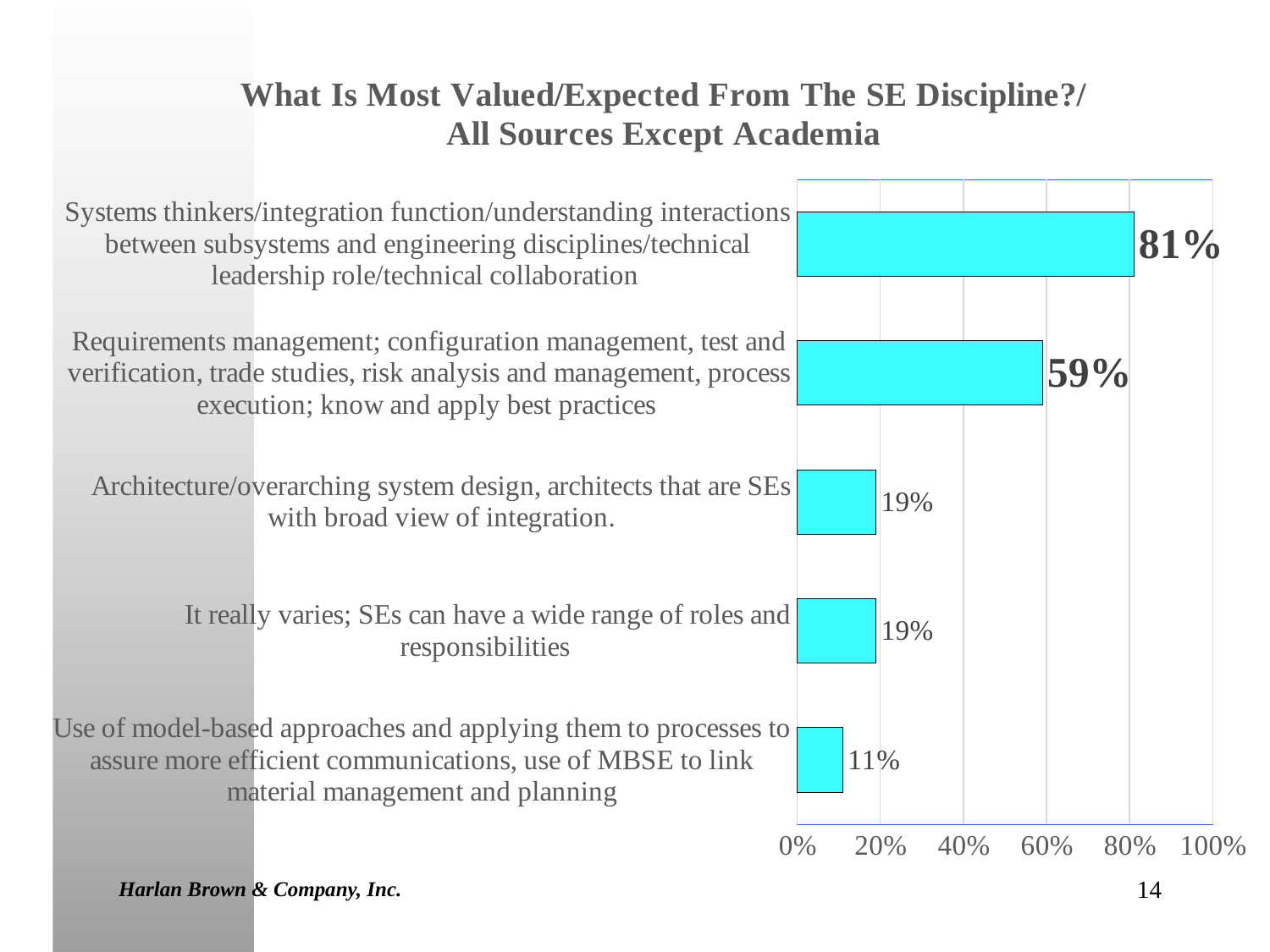
What value is shown for the 'Systems thinkers/integration function' category? 81% What value is shown for 'Use of model-based approaches' category? 11% What is the difference between the 'It really varies' value and the 'Use of model-based approaches' value? 8% What value is shown for the 'Requirements management; configuration management' category? 59% Which is larger: the value for 'Requirements management' or the value for 'It really varies'? Requirements management; configuration management, test and verification, trade studies, risk analysis and management, process execution; know and apply best practices What kind of chart is shown on the slide? Bar chart Which category has the highest value? Systems thinkers/integration function/understanding interactions between subsystems and engineering disciplines/technical leadership role/technical collaboration What value is shown for 'Architecture/overarching system design, architects that are SEs with broad view of integration.'? 19% Which category has the lowest value? Use of model-based approaches and applying them to processes to assure more efficient communications, use of MBSE to link material management and planning What is the title of the chart? What Is Most Valued/Expected From The SE Discipline?/ All Sources Except Academia What is the difference between the 'Systems thinkers' value and the 'Requirements management' value? 22% How many categories are plotted in the chart? 5